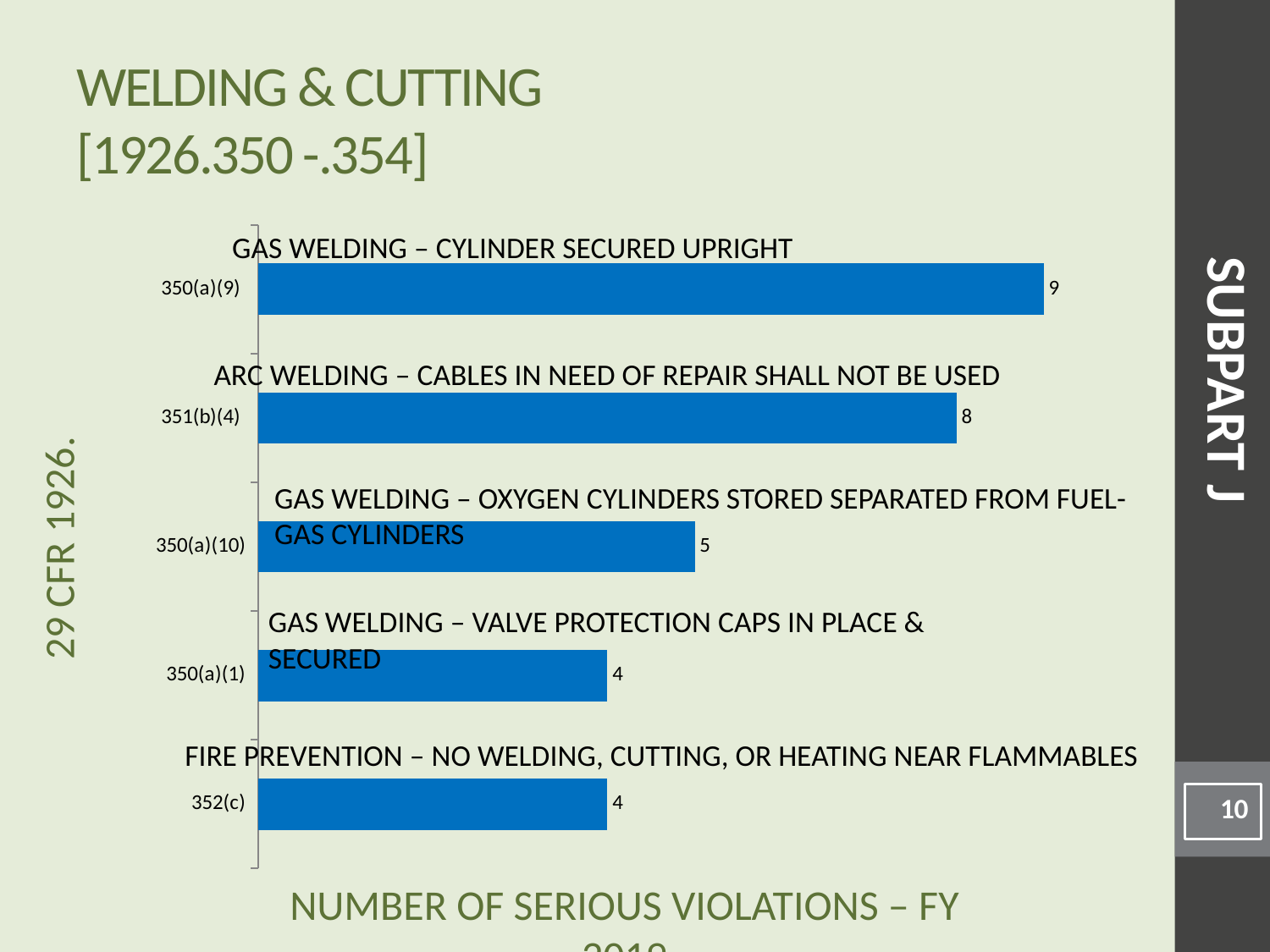
How many standards (bars) are shown in the chart? 5 Which standard is described as 'GAS WELDING – CYLINDER SECURED UPRIGHT'? 350(a)(9) What is the total number of serious violations across all five bars? 30 What is the number of serious violations for 352(c)? 4 What is the number of serious violations for 350(a)(9)? 9 What is the number of serious violations for 351(b)(4)? 8 What kind of chart is shown on the slide? Bar chart What is the number of serious violations for 350(a)(10)? 5 What is the difference in serious violations between 351(b)(4) and 350(a)(1)? 4 What is the difference in serious violations between 350(a)(9) and 350(a)(10)? 4 Which standard has the highest number of serious violations? 350(a)(9) Which has more serious violations, 351(b)(4) or 350(a)(10)? 351(b)(4)